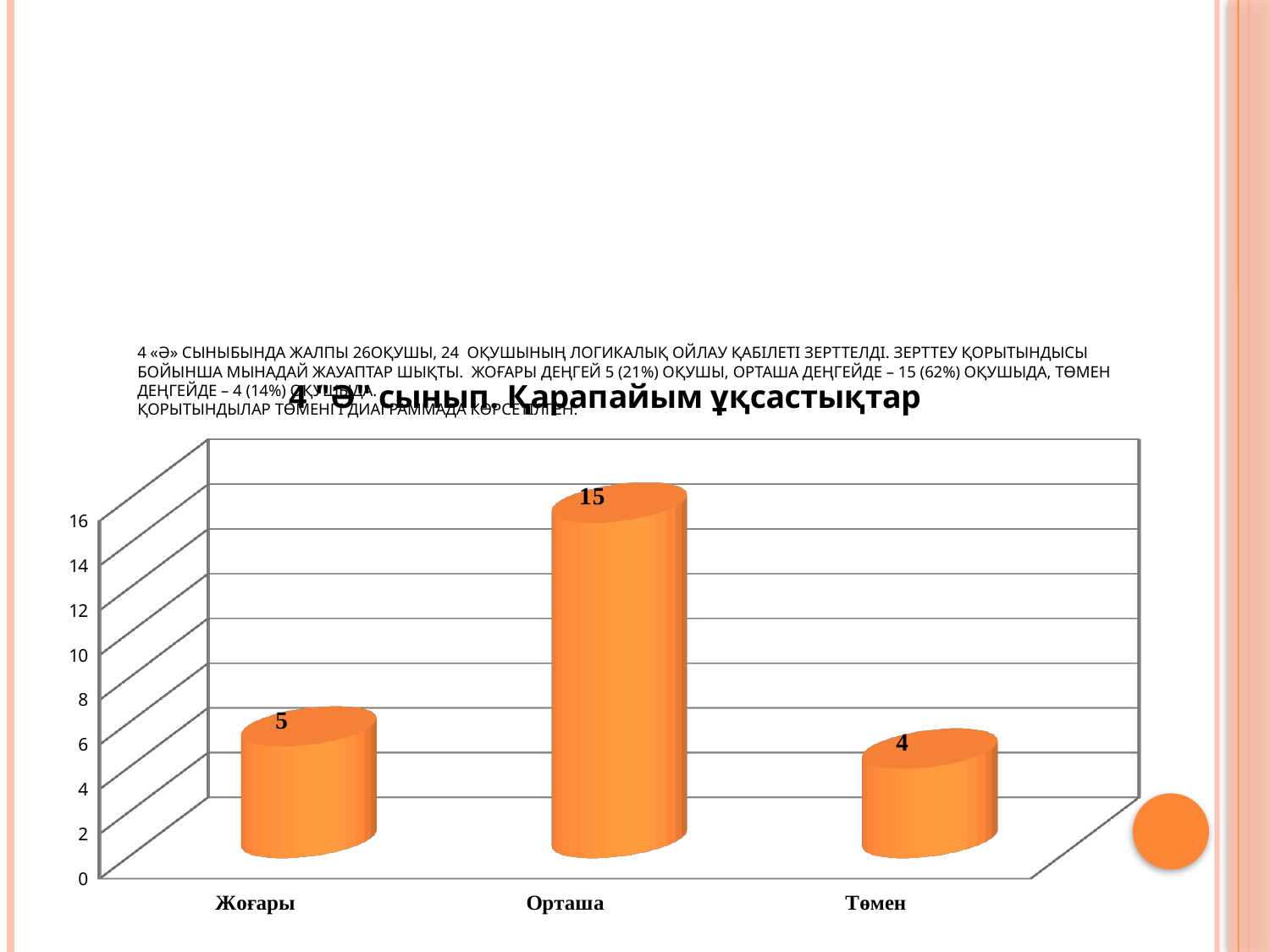
What is the value for Орташа? 15 Is the value for Орташа greater or less than 10? greater What is the difference between the values for Жоғары and Төмен? 1 How many categories are shown on the x axis? 3 Which category has the highest value? Орташа What is the title of the chart? 4 "Ә" сынып. Қарапайым ұқсастықтар What is the value for Төмен? 4 Which category has the lowest value? Төмен What kind of chart is shown on the slide? bar chart Which is larger, the value for Орташа or the value for Төмен? Орташа What is the value for Жоғары? 5 What is the difference between the values for Орташа and Жоғары? 10